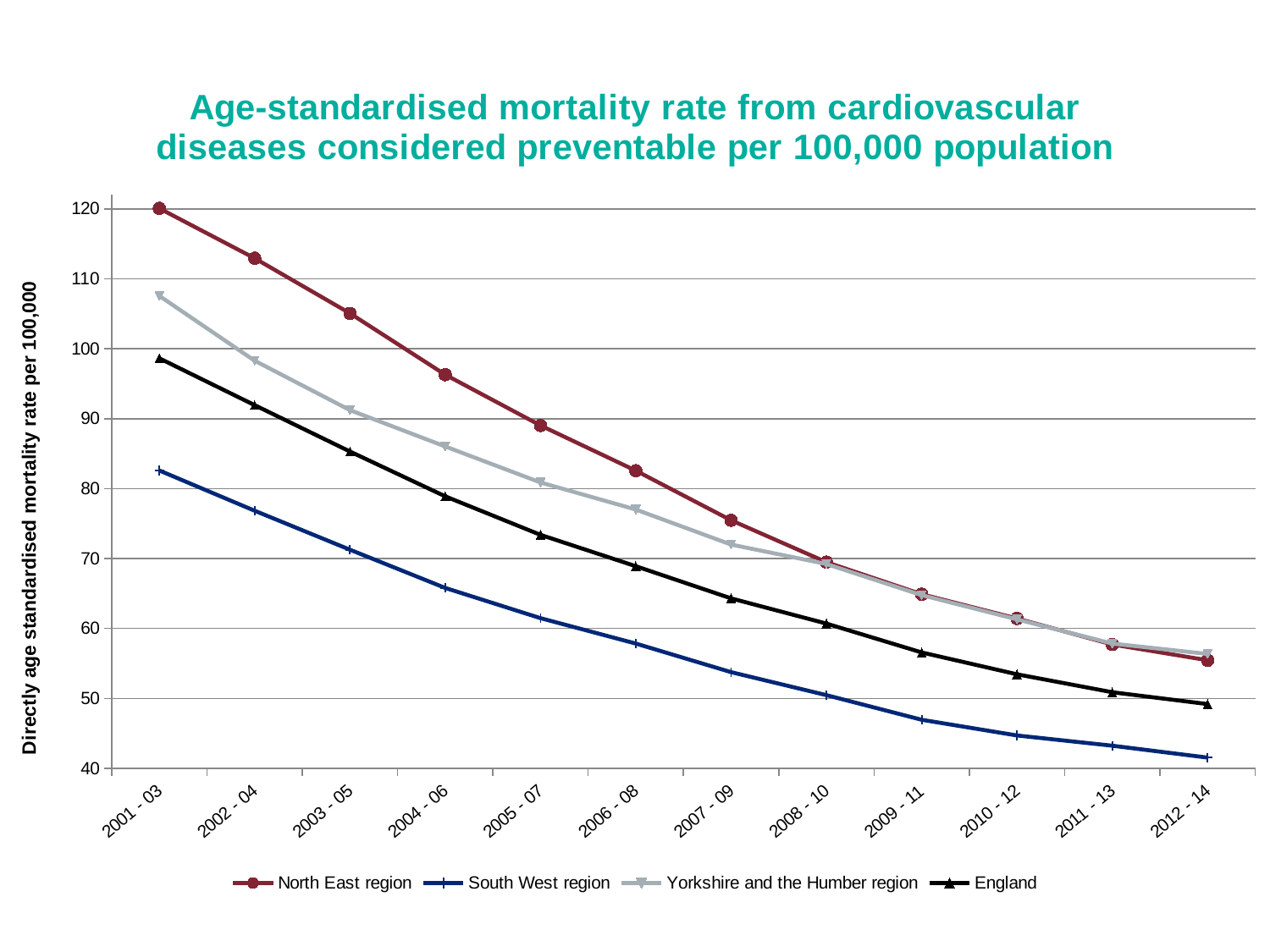
In 2005 - 07, which is larger: the value for the North East region or the value for England? North East region Which series has the lowest mortality rate in 2012 - 14? South West region Do the values for England rise or fall from 2001 - 03 to 2012 - 14? Fall Is the value for the South West region in 2012 - 14 greater or less than 50? less What kind of chart is shown on the slide? Line chart Which region has the highest mortality rate in 2001 - 03? North East region How many time periods are shown along the x axis? 12 What is the label on the y axis of the chart? Directly age standardised mortality rate per 100,000 Is the value for the North East region in 2003 - 05 greater or less than 100? greater Is the value for the Yorkshire and the Humber region in 2001 - 03 greater or less than 100? greater What is the value for the North East region in 2001 - 03? 120 How many series does the legend list? 4